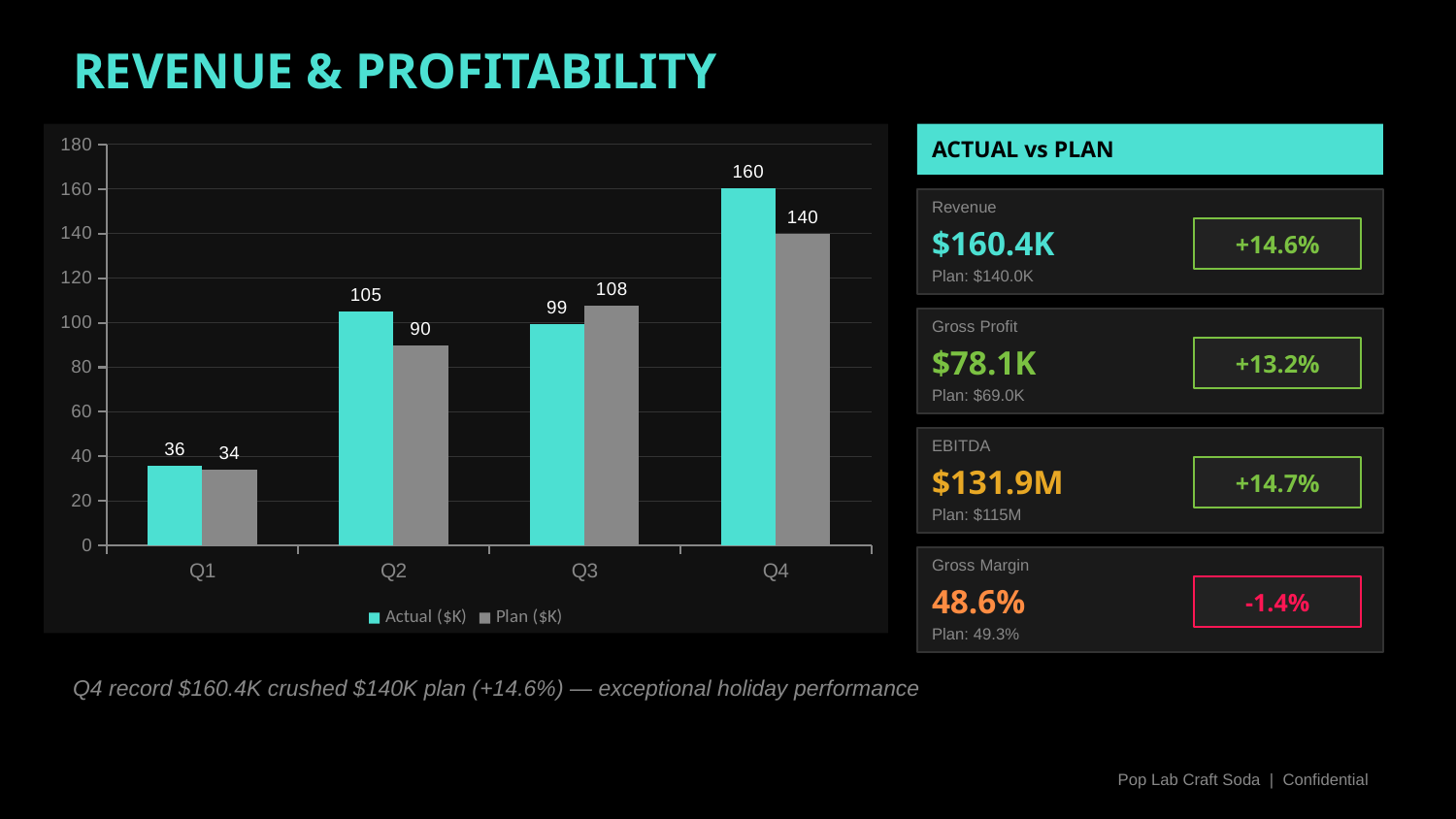
What is the Plan ($K) value for Q2? 90 What is the difference between the Actual ($K) and Plan ($K) values for Q2? 15 What is the difference between the Actual ($K) and Plan ($K) values for Q4? 20 What is the Actual ($K) value for Q1? 36 Which quarter has the highest Actual ($K) value? Q4 How many quarters are shown on the x axis of the chart? 4 Which quarter has the lowest Plan ($K) value? Q1 What kind of chart is shown on the slide? Bar chart Which colour represents the Actual ($K) series in the chart? Teal What is the Actual ($K) value for Q4? 160 In Q3, which is larger: Actual ($K) or Plan ($K)? Plan ($K) How many series does the chart legend list? 2